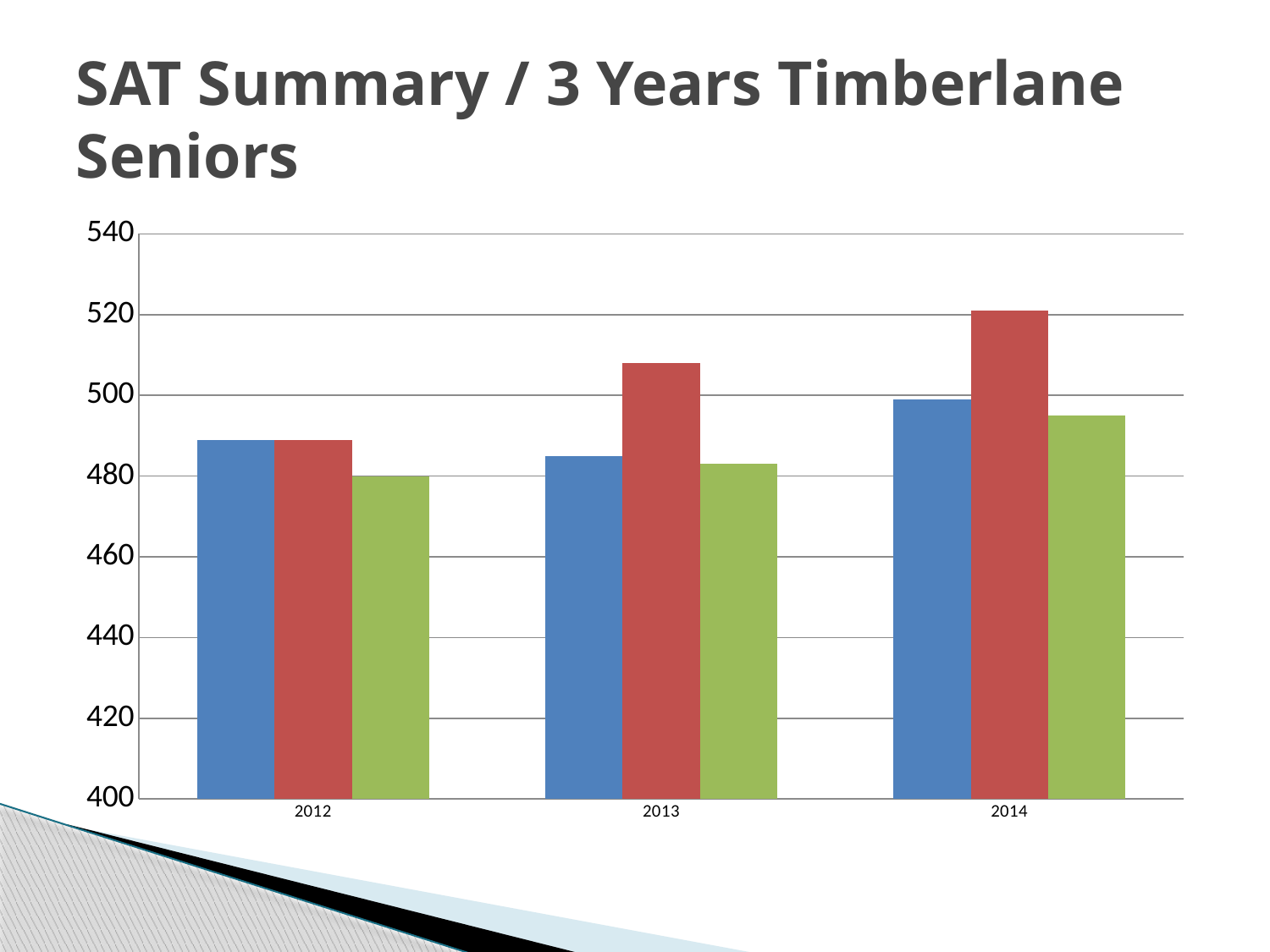
How many years are shown on the x axis of the chart? 3 Is the value of the red bar for 2013 greater or less than 500? greater How many bars are plotted for each year in the chart? 3 Is the value of the blue bar for 2012 greater or less than 480? greater Which year has the tallest bar in the chart? 2014 Which is larger in 2013, the red bar or the blue bar? the red bar Which is larger, the blue bar for 2014 or the blue bar for 2012? the blue bar for 2014 Is the value of the red bar for 2014 greater or less than 500? greater Do the red bars rise or fall from 2012 to 2014? rise What kind of chart is shown on the slide? bar chart What is the title of the slide containing the chart? SAT Summary / 3 Years Timberlane Seniors